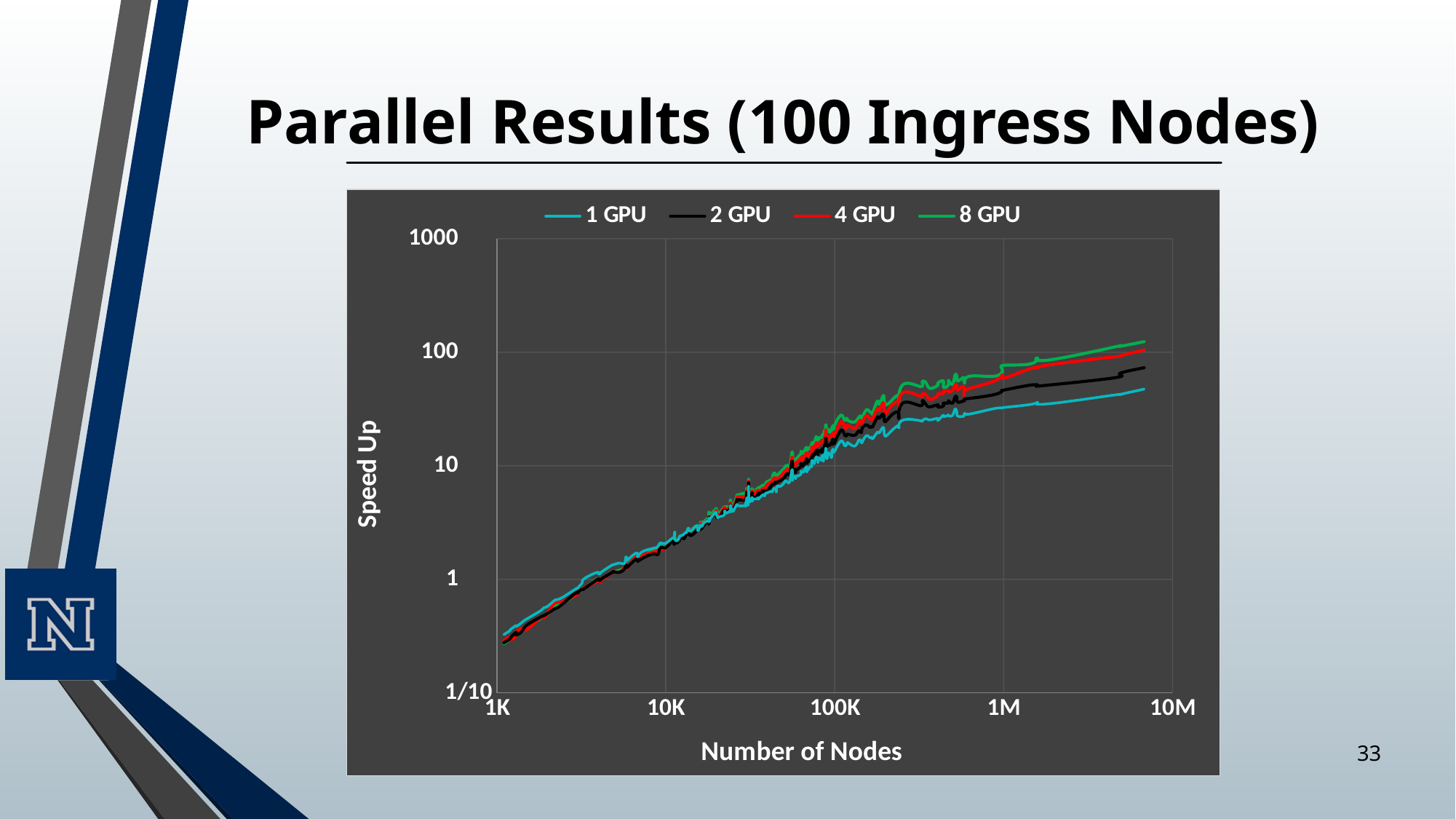
At the right end of the chart, is the speed up for 8 GPU greater or less than 100? greater At 1K nodes, is the speed up for 1 GPU greater or less than 1? less Which series has the lowest speed up at the right end of the chart? 1 GPU At 1M nodes, is the speed up for 1 GPU greater or less than 10? greater Which series reaches the highest speed up at the right end of the chart? 8 GPU What kind of chart is shown on the slide? line chart What is the label of the y axis? Speed Up What is the label of the x axis? Number of Nodes How many series does the legend list? 4 Do the speed up values rise or fall as the number of nodes increases? rise At the right end of the chart, which series has the larger speed up, 8 GPU or 1 GPU? 8 GPU